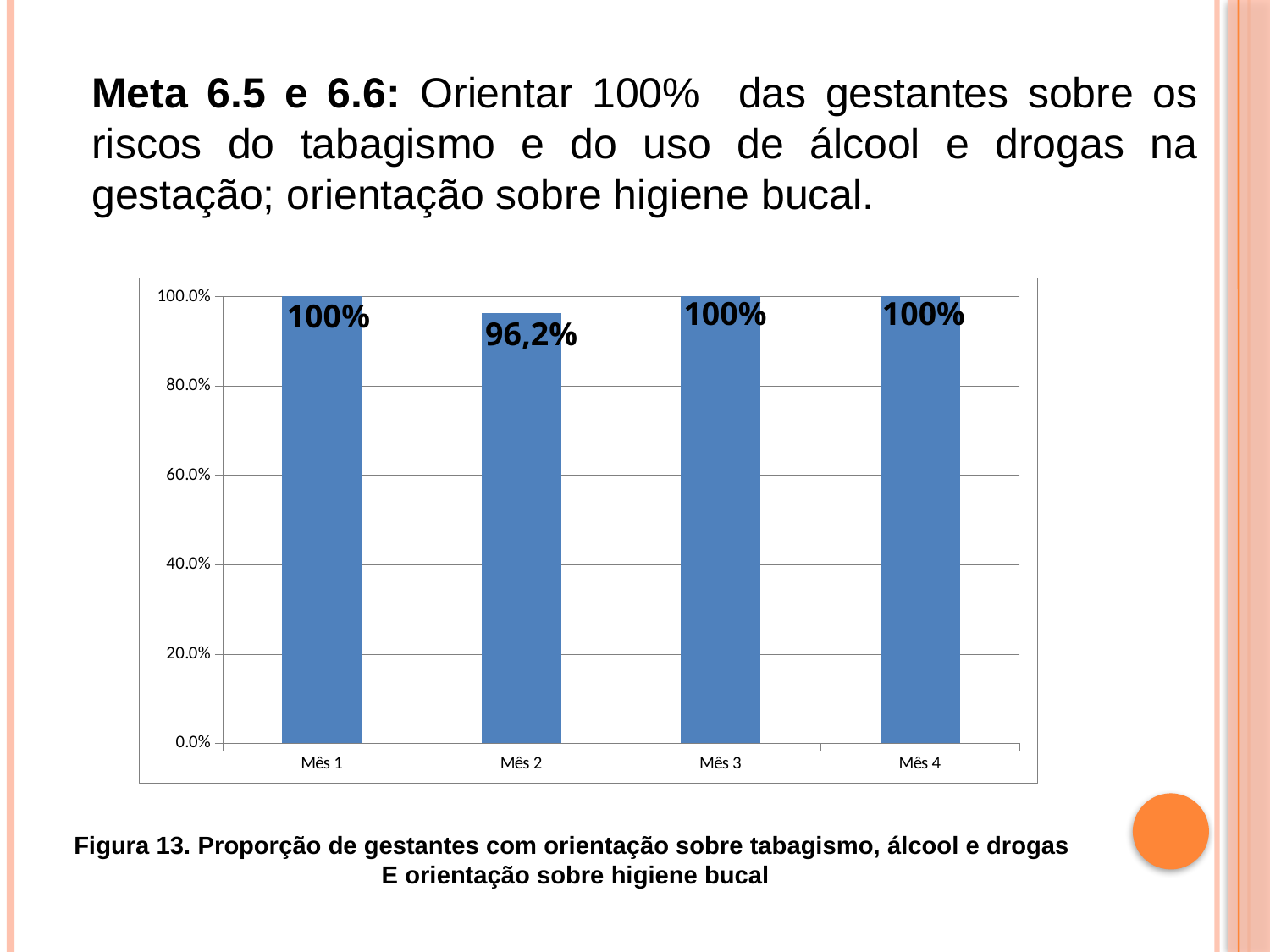
How many months are shown on the x axis? 4 What is the value for Mês 1? 100% What colour are the bars in the chart? blue How many bars reach 100%? 3 What kind of chart is shown on the slide? bar chart What is the value for Mês 4? 100% Is the value for Mês 2 greater or less than 80.0%? greater Which is larger, the value for Mês 2 or the value for Mês 3? Mês 3 What is the value for Mês 2? 96,2% Which month has the lowest value? Mês 2 What is the figure number given in the caption below the chart? Figura 13